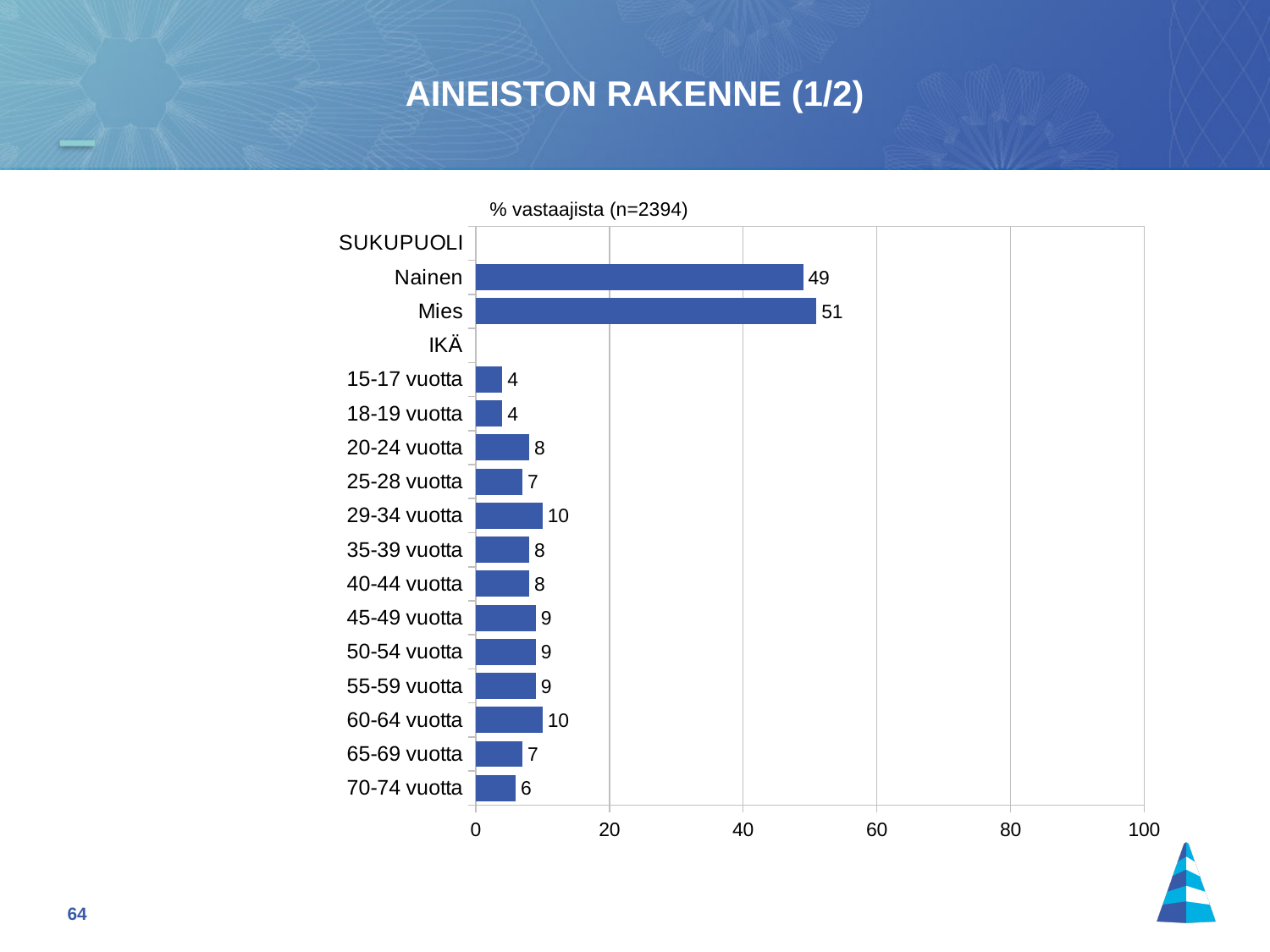
What is the value for Nainen? 49 Is the value for Mies greater or less than 40? greater What is the value for Mies? 51 Which is larger, the value for 20-24 vuotta or 25-28 vuotta? 20-24 vuotta What is the value for 29-34 vuotta? 10 What is the difference between the values for Mies and Nainen? 2 What is the value for 45-49 vuotta? 9 What kind of chart is shown on the slide? bar chart How many age groups (vuotta categories) are shown in the chart? 13 What is the title of the chart? % vastaajista (n=2394) What is the value for 70-74 vuotta? 6 Which category has the highest value in the chart? Mies